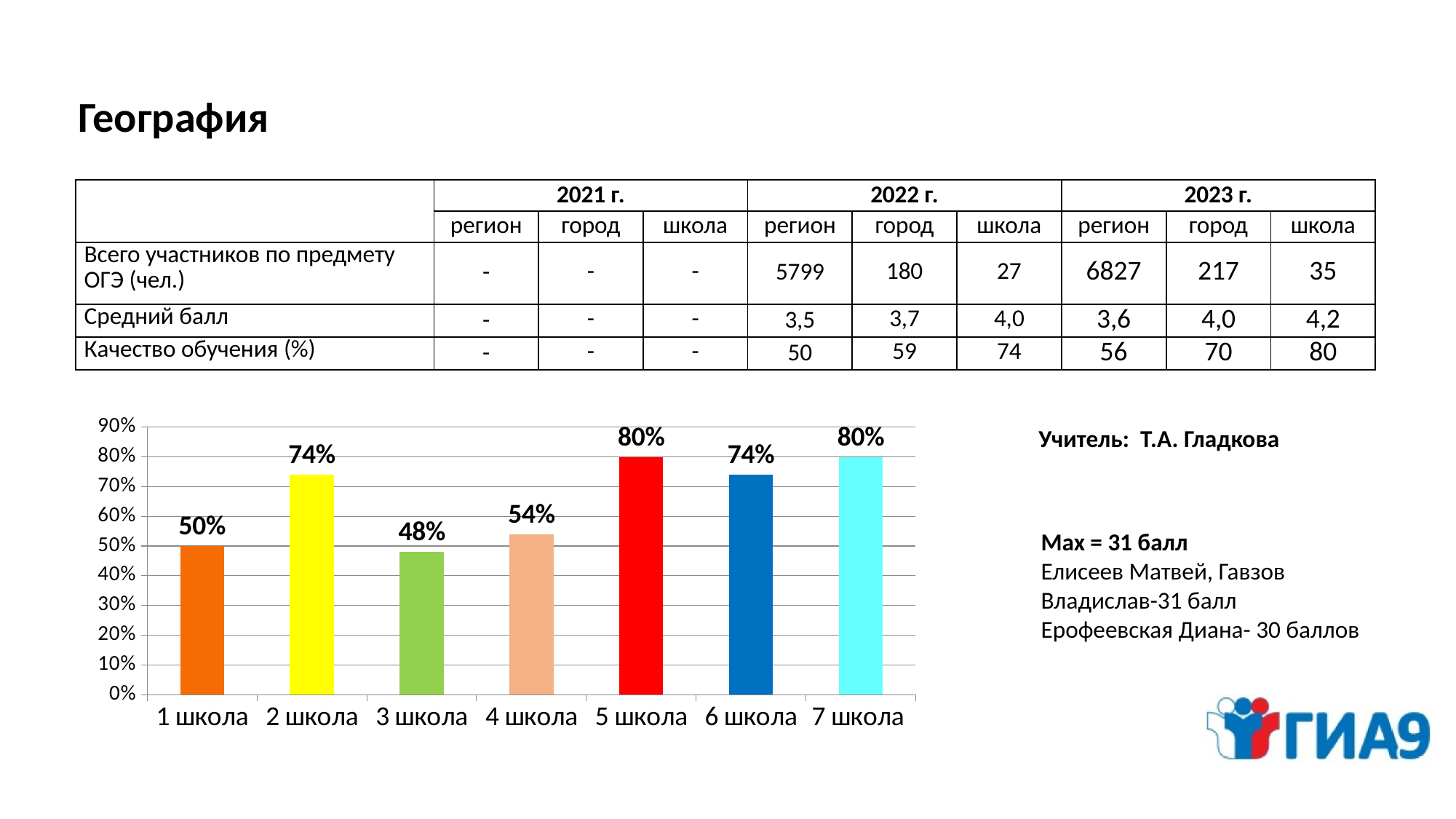
Which is larger, the value for 4 школа or the value for 6 школа? 6 школа Which categories share the highest value in the bar chart? 5 школа and 7 школа What kind of chart is shown on the slide? bar chart What is the value for 6 школа in the bar chart? 74% What colour is the bar for 5 школа? red What is the difference between the values for 5 школа and 3 школа? 32% How many categories are shown on the x axis of the bar chart? 7 Is the value for 3 школа greater or less than 50%? less Which category has the lowest value in the bar chart? 3 школа What is the value for 1 школа in the bar chart? 50% What is the difference between the values for 2 школа and 1 школа? 24% What is the value for 4 школа in the bar chart? 54%